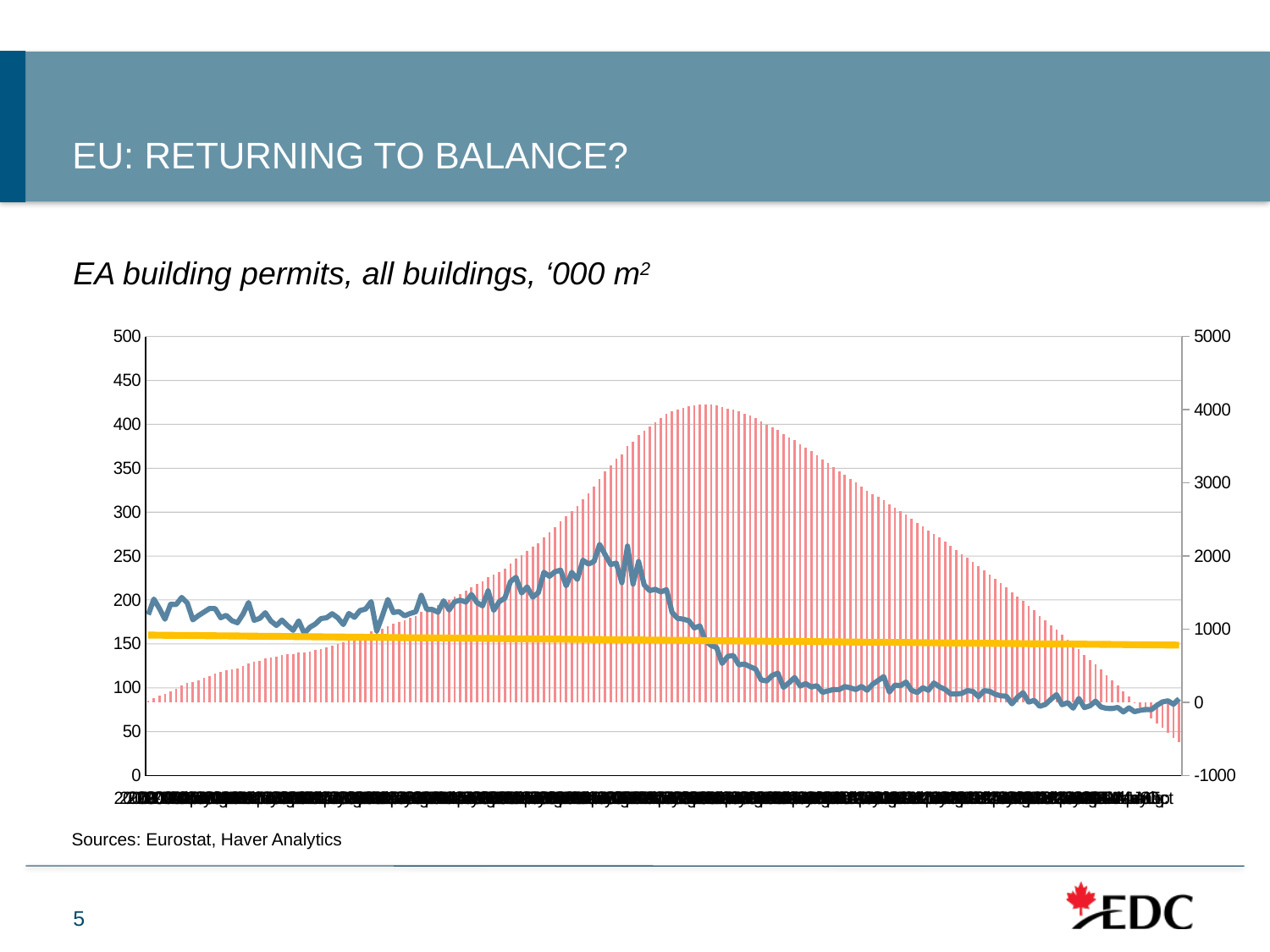
Is the highest point of the blue line greater or less than 200 on the left axis? greater What is the title of the chart? EA building permits, all buildings, '000 m² Overall, does the blue line rise or fall from the left end of the chart to the right end? fall Is the red bar at the far right end of the chart greater or less than 0 on the right axis? less Is the value of the blue line at the far left end of the chart greater or less than 150 on the left axis? greater What kind of chart is shown on the slide? a combined bar and line chart Do the red bars rise or fall across the left half of the chart, up to their peak? rise Do the red bars rise or fall across the right half of the chart? fall What is the highest value shown on the left vertical axis? 500